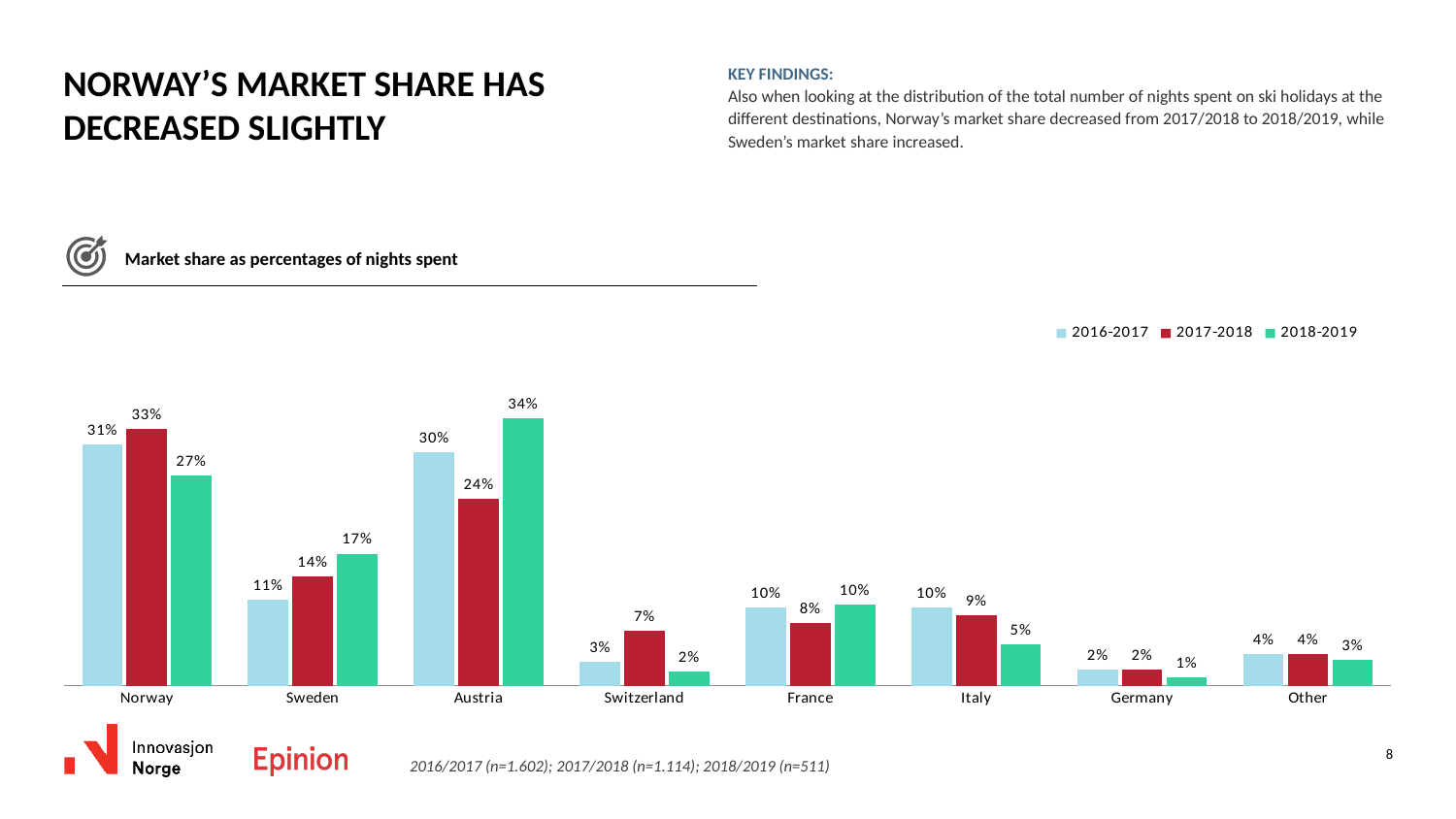
What is the market share for Sweden in 2016-2017? 11% How many series does the legend list? 3 Which destination has the lowest market share in 2018-2019? Germany What is the difference between Norway's market share in 2017-2018 and 2018-2019? 6% What kind of chart is shown on the slide? Bar chart Does Sweden's market share rise or fall from 2016-2017 to 2018-2019? Rise Which is larger, Sweden's market share in 2018-2019 or Switzerland's market share in 2018-2019? Sweden's market share in 2018-2019 How many destination categories are shown on the x axis? 8 Which destination has the highest market share in 2018-2019? Austria What is the market share for Norway in 2018-2019? 27% What is the market share for Austria in 2017-2018? 24% What is the title of the chart? Market share as percentages of nights spent